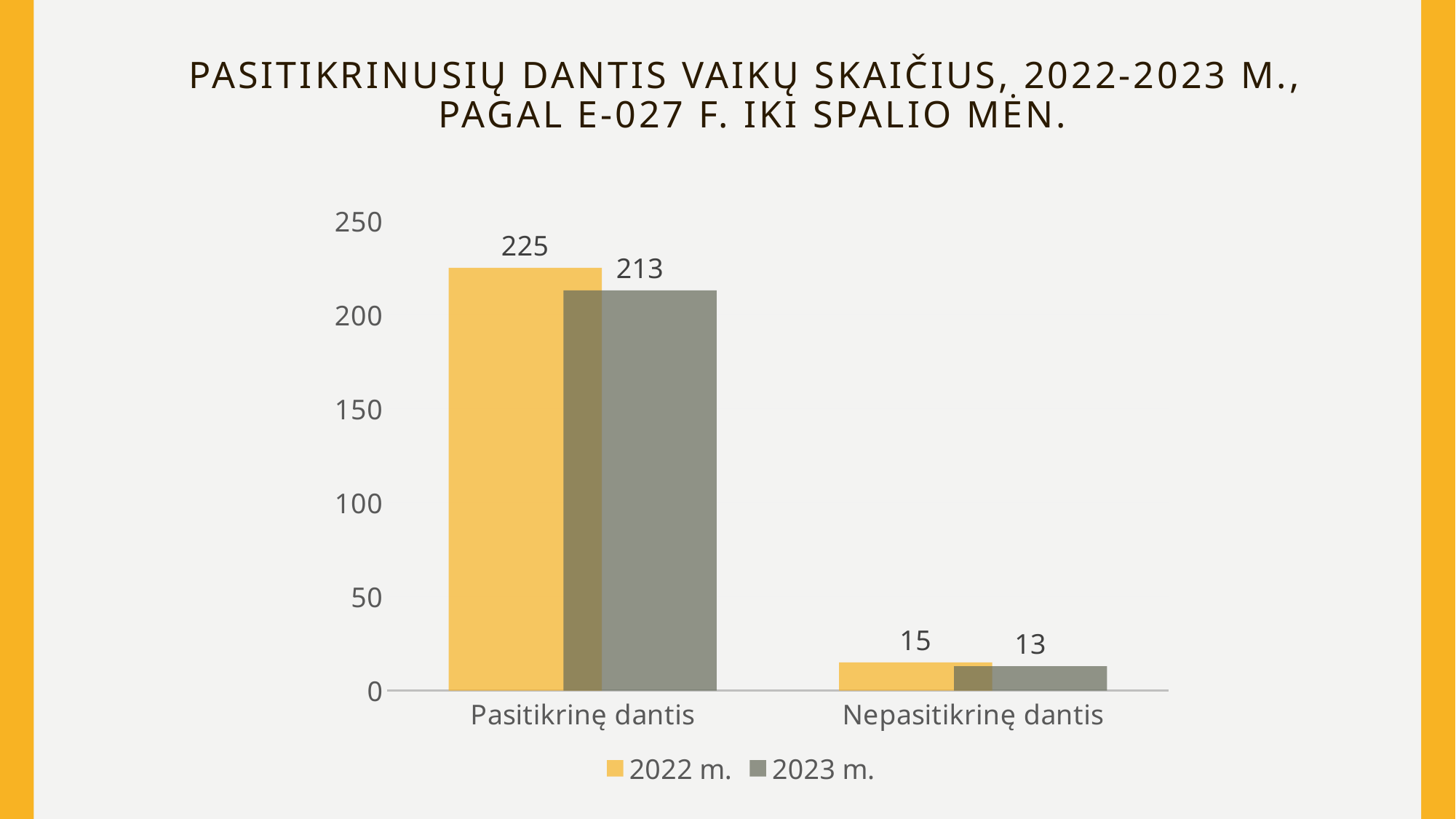
What is the difference between the 2022 m. and 2023 m. values for 'Pasitikrinę dantis'? 12 Is the 2023 m. value for 'Pasitikrinę dantis' greater or less than 200? greater What is the value for 'Nepasitikrinę dantis' in the 2022 m. series? 15 How many series does the legend list? 2 Which category has the lowest value in the 2023 m. series? Nepasitikrinę dantis Which category has the highest value in the 2022 m. series? Pasitikrinę dantis What is the value for 'Pasitikrinę dantis' in the 2023 m. series? 213 Which is larger for 'Nepasitikrinę dantis': the 2022 m. value or the 2023 m. value? 2022 m. What is the value for 'Nepasitikrinę dantis' in the 2023 m. series? 13 How many categories are shown on the x axis? 2 What is the value for 'Pasitikrinę dantis' in the 2022 m. series? 225 What kind of chart is shown on the slide? bar chart